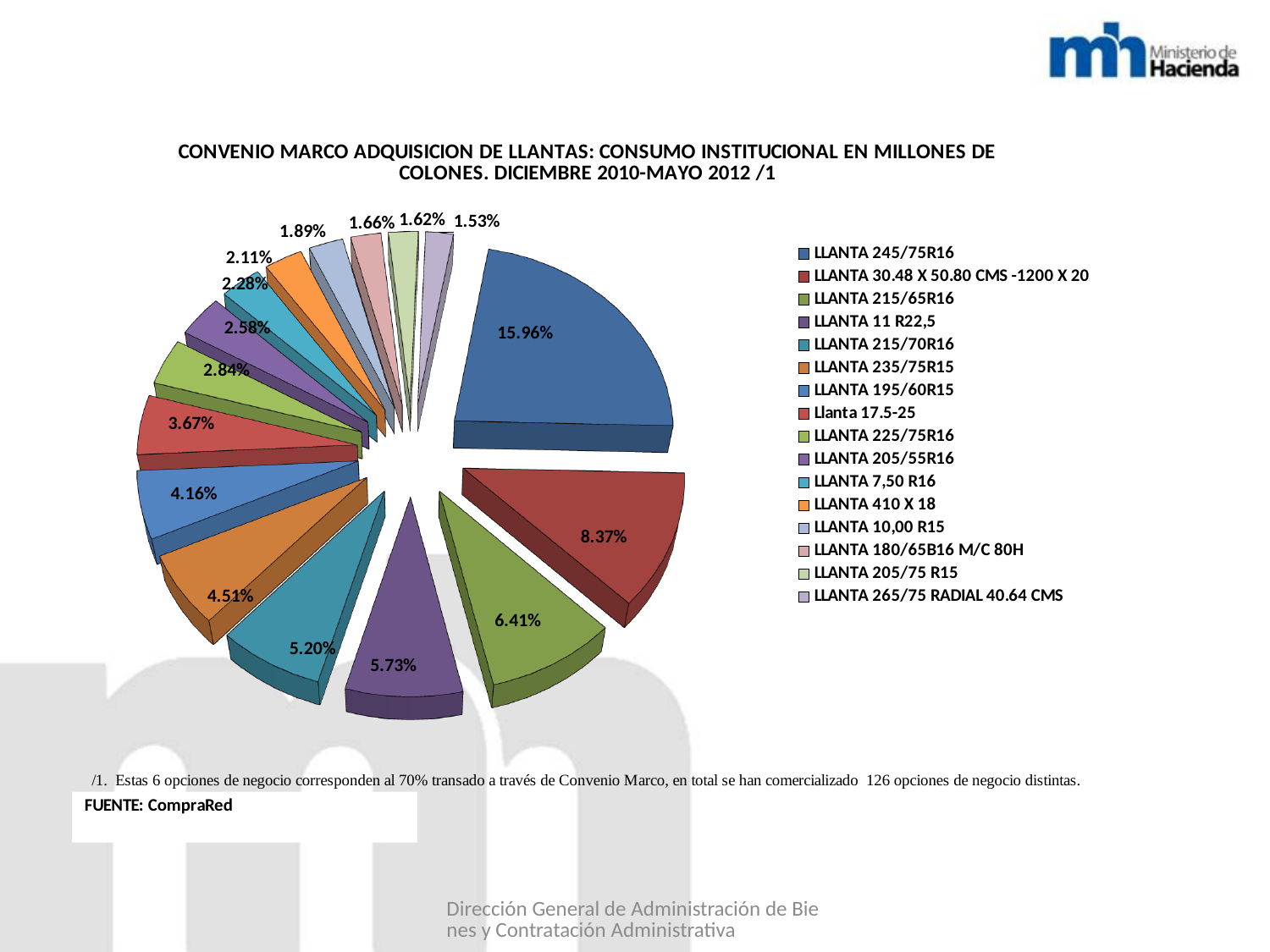
Which category has the smallest slice of the pie? LLANTA 265/75 RADIAL 40.64 CMS What kind of chart is shown on the slide? pie chart What share of the pie does LLANTA 245/75R16 represent? 15.96% Which is larger, the value for LLANTA 215/70R16 or the value for LLANTA 235/75R15? LLANTA 215/70R16 How many slices does the pie chart have? 16 Which category has the largest slice of the pie? LLANTA 245/75R16 What is the value shown for Llanta 17.5-25? 3.67% What source is cited below the chart? CompraRed What is the value shown for LLANTA 11 R22,5? 5.73% What is the difference between the values for LLANTA 245/75R16 and LLANTA 30.48 X 50.80 CMS -1200 X 20? 7.59% What is the value shown for LLANTA 215/65R16? 6.41% What is the value shown for LLANTA 30.48 X 50.80 CMS -1200 X 20? 8.37%